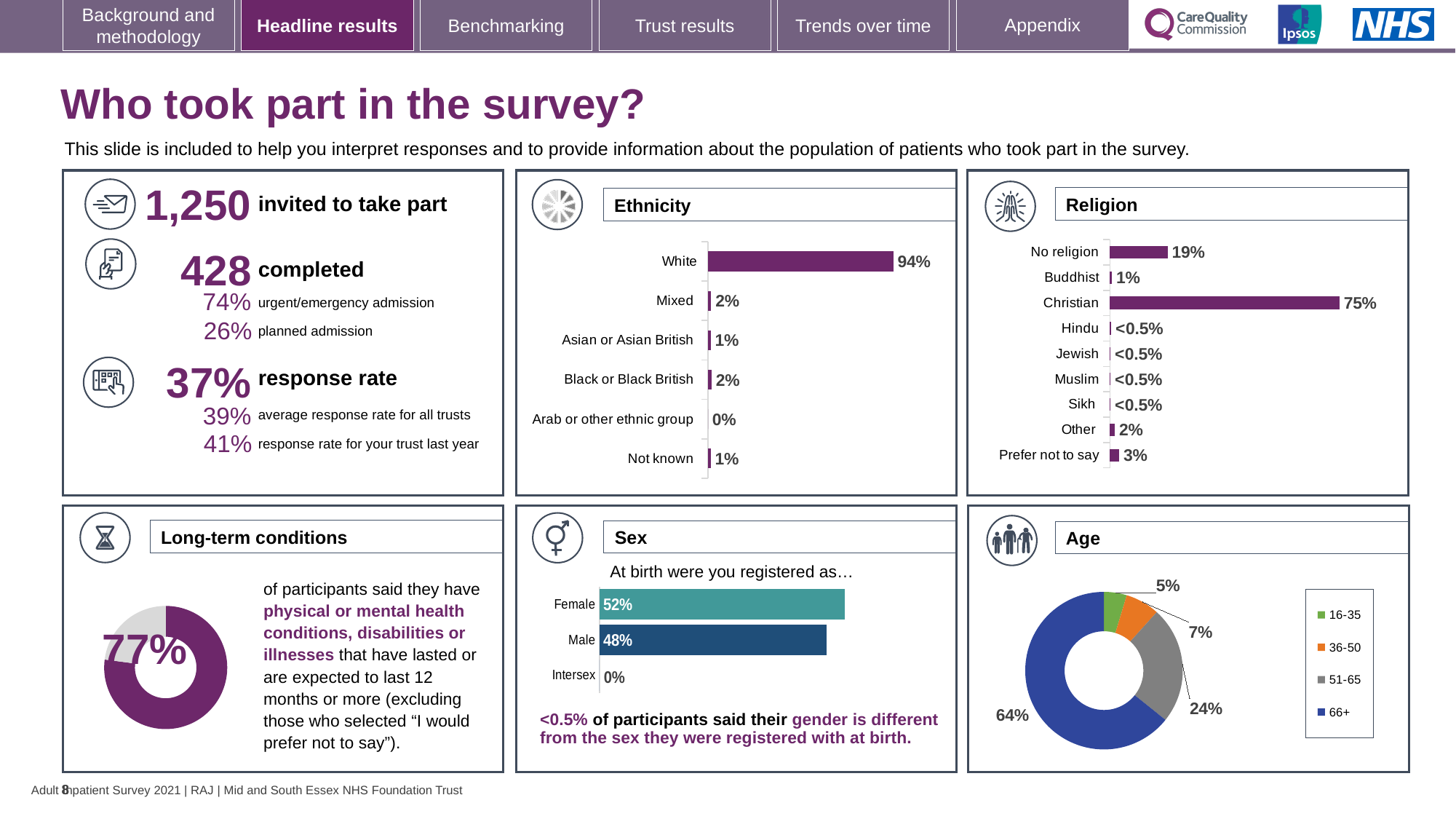
In the Sex chart, which is larger, Female or Male? Female In the Religion chart, what is the difference between the Christian and No religion values? 56 percentage points What kind of chart is the Age chart? Doughnut (pie) chart In the Ethnicity chart, what percentage of participants were White? 94% In the Religion chart, which category has the highest value? Christian How many categories does the legend of the Age chart list? 4 In the Religion chart, what is the value for No religion? 19% In the Age chart, what is the value for the 51-65 group? 24% In the Long-term conditions chart, what percentage of participants said they have a long-term condition? 77% In the Sex chart, what is the value for Male? 48% In the Age chart, what share of participants were aged 66+? 64% How many categories are shown in the Ethnicity chart? 6